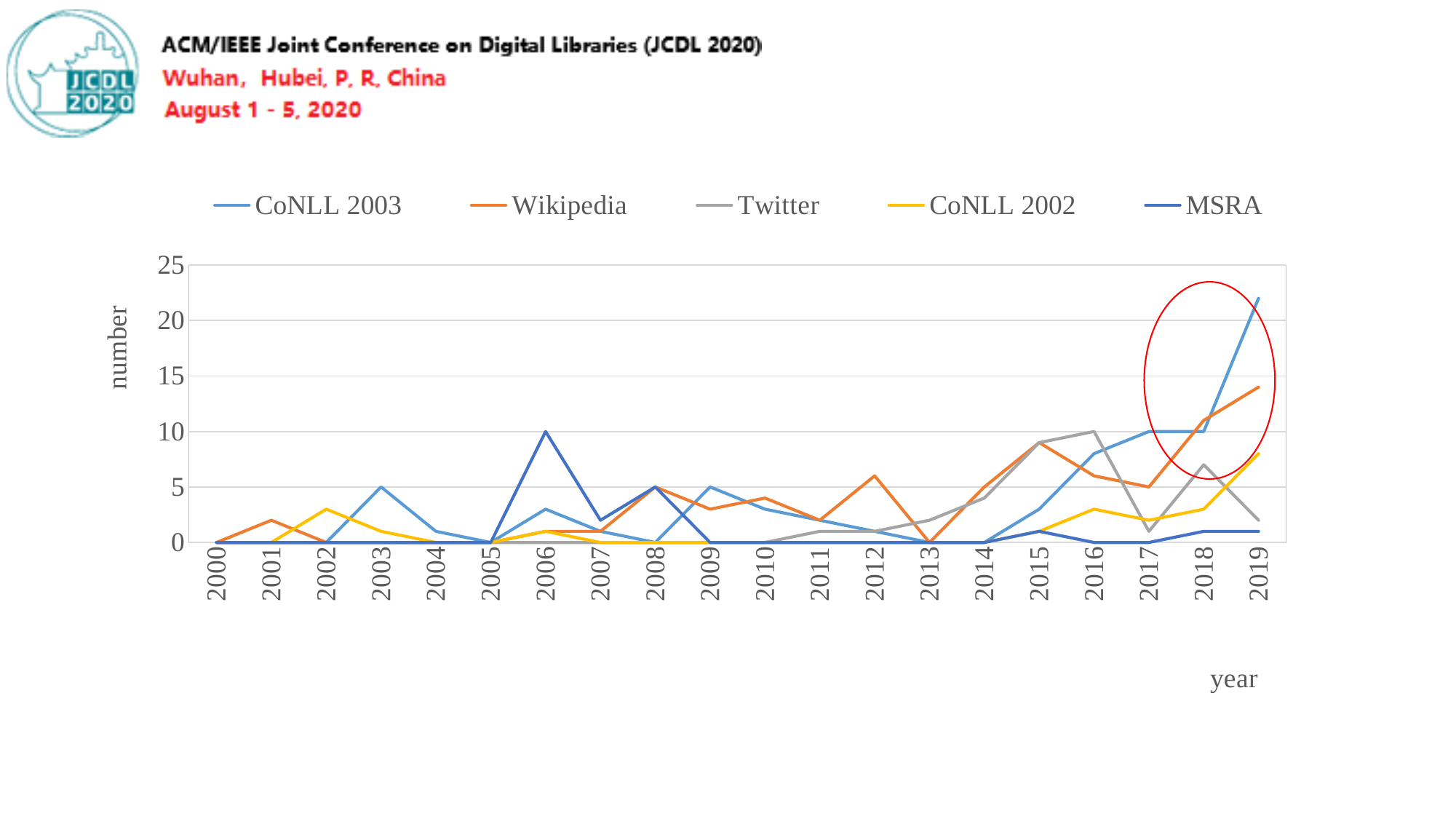
Which series has the highest value in 2019? CoNLL 2003 What is the label of the y axis? number How many years are shown along the x axis? 20 What is the value for CoNLL 2003 in 2018? 10 What is the value for MSRA in 2006? 10 What is the value for Twitter in 2016? 10 Is the value for Wikipedia in 2019 greater or less than 15? less Is the value for CoNLL 2003 in 2019 greater or less than 20? greater In 2019, which is larger, the value for Wikipedia or the value for MSRA? Wikipedia Does the CoNLL 2003 line rise or fall from 2017 to 2019? rise How many series does the legend list? 5 What kind of chart is shown on the slide? line chart